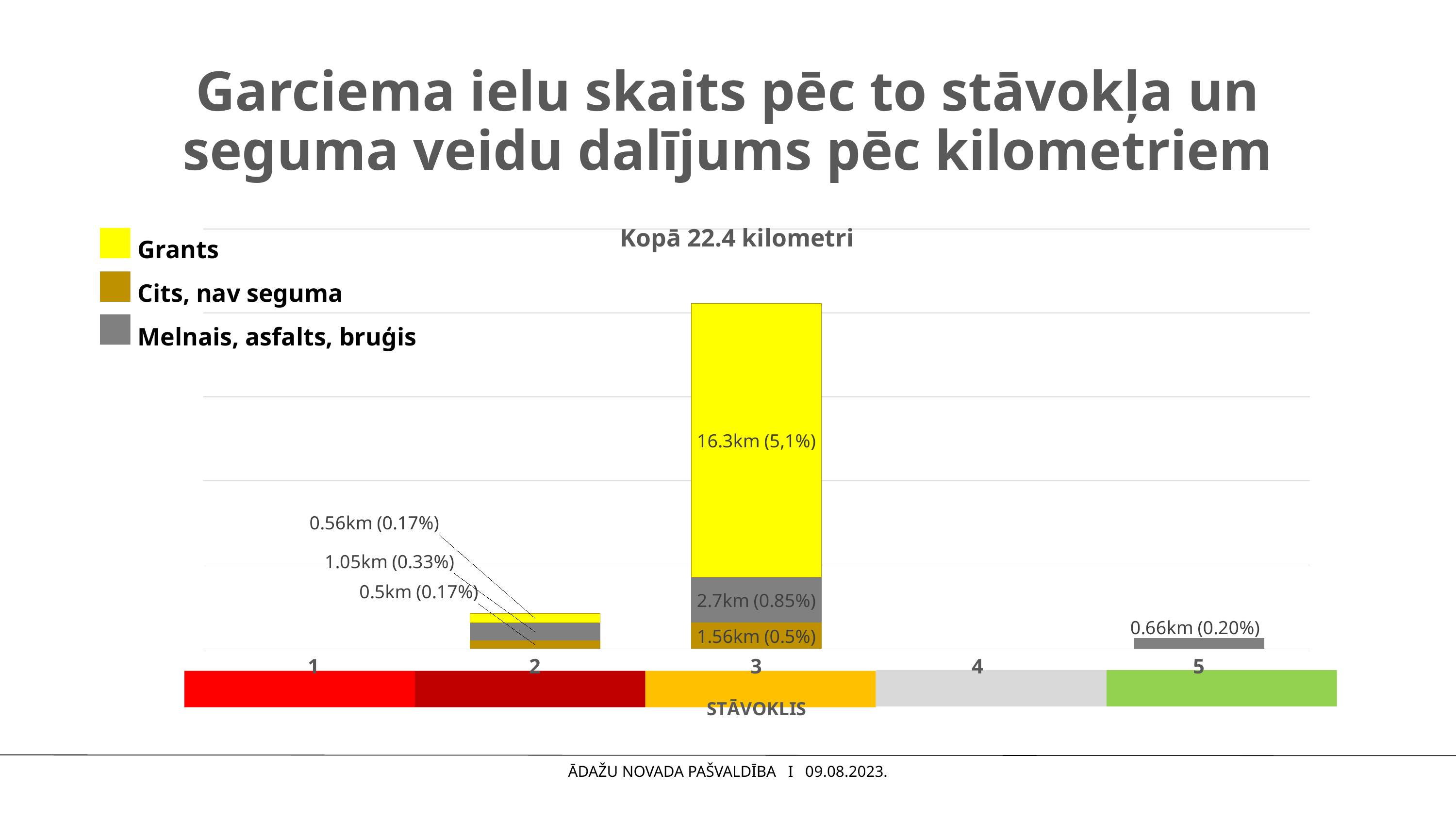
What kind of chart is shown on the slide? Stacked bar chart What is the Grants value for condition category 3? 16.3km What is the Melnais, asfalts, bruģis value for condition category 3? 2.7km What is the total of the stacked bar for condition category 2? 2.11km How many series does the legend list? 3 What is the Cits, nav seguma value for condition category 3? 1.56km What total length is stated in the chart title? 22.4 kilometri Which is larger for condition category 2: the Melnais, asfalts, bruģis value or the Cits, nav seguma value? Melnais, asfalts, bruģis What is the difference between the Grants value and the Melnais, asfalts, bruģis value for condition category 3? 13.6km What is the Melnais, asfalts, bruģis value for condition category 5? 0.66km What is the Grants value for condition category 2? 0.56km Which condition category has the tallest stacked bar? 3